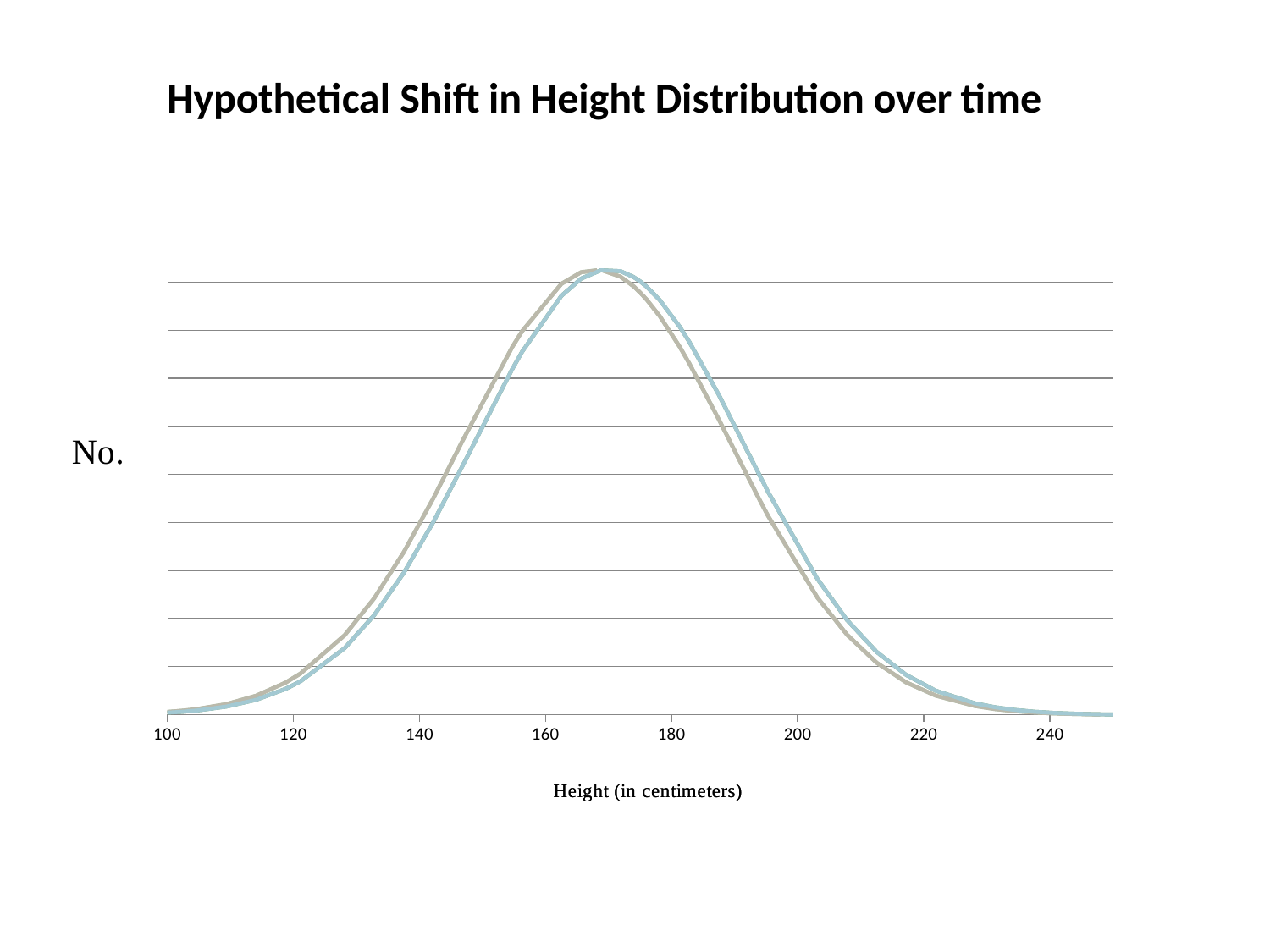
Do the plotted values rise or fall as height increases from 100 to 160 centimeters? rise What kind of chart is shown on the slide? line chart How many lines are plotted on the chart? 2 Do the plotted values rise or fall as height increases from 180 to 240 centimeters? fall What is the title of the chart? Hypothetical Shift in Height Distribution over time Is the peak of the curves located at a height greater or less than 140 centimeters? greater What is the label on the horizontal axis of the chart? Height (in centimeters) Is the peak of the curves located at a height greater or less than 200 centimeters? less